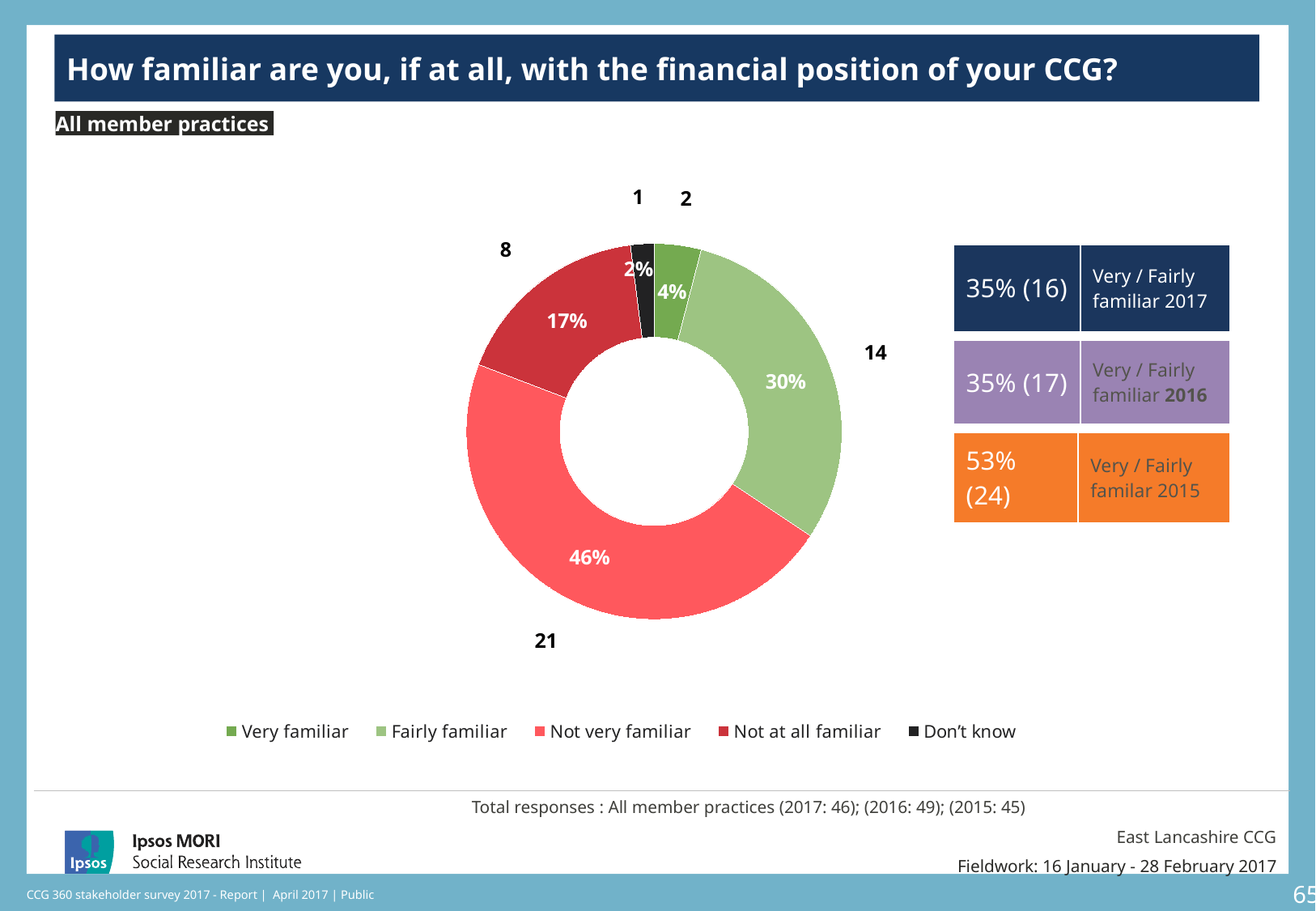
Which response category has the smallest share of the chart? Don't know Which is larger: the share for 'Not at all familiar' or the share for 'Very familiar'? Not at all familiar How many response categories does the chart show? 5 What is the combined percentage of 'Very familiar' and 'Fairly familiar' responses in 2017, as shown in the box to the right of the chart? 35% (16) How many respondents (count) answered 'Very familiar'? 2 What percentage of respondents said they are 'Not very familiar' with the financial position of their CCG? 46% What is the difference in percentage points between 'Not very familiar' and 'Fairly familiar'? 16 What percentage of respondents said they are 'Not at all familiar'? 17% What percentage of respondents said they are 'Fairly familiar'? 30% What colour represents 'Don't know' in the chart? Black What kind of chart is shown on the slide? Donut (pie) chart Which response category has the largest share of the chart? Not very familiar